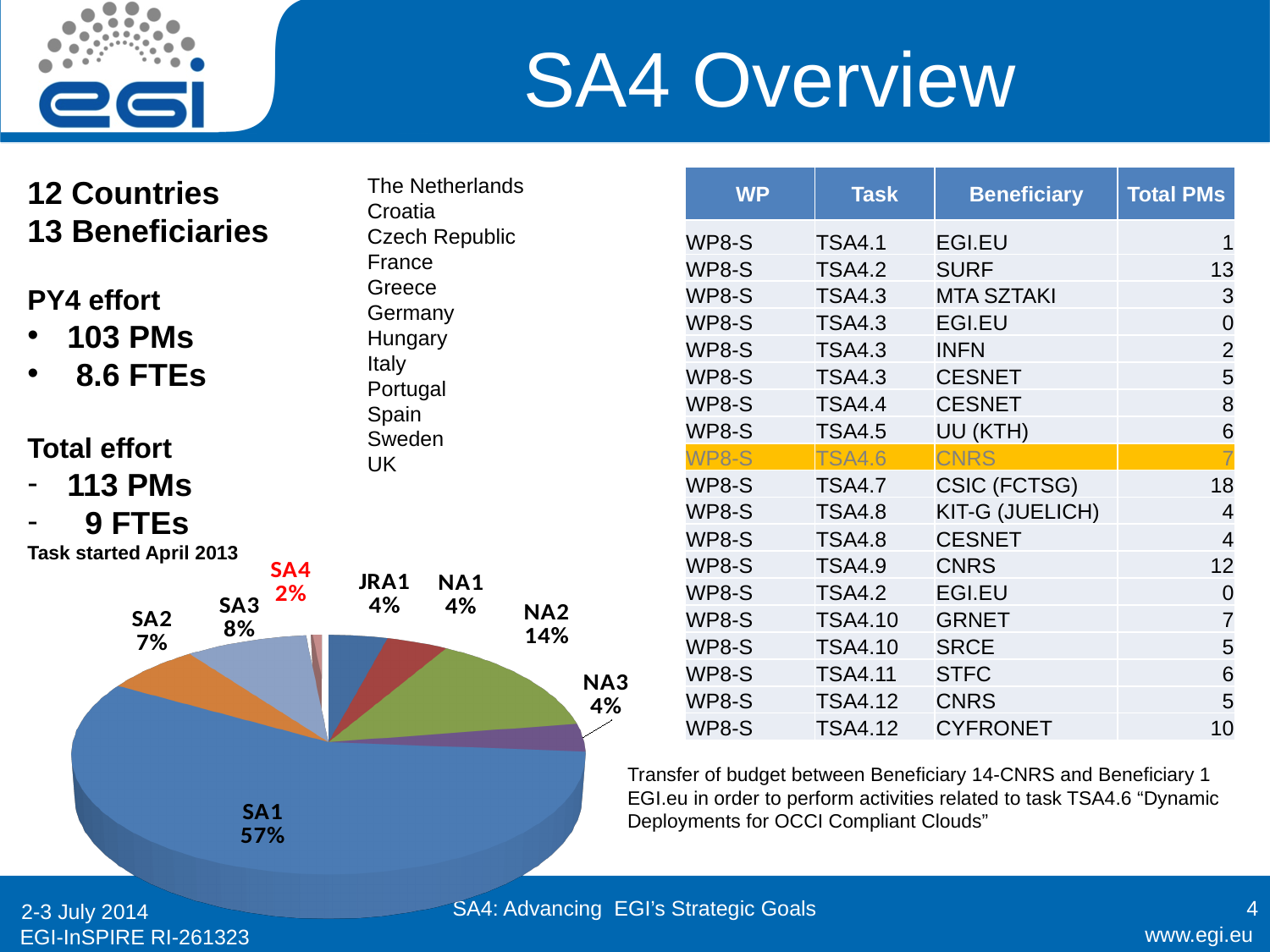
What share of the pie does SA4 have? 2% Which slice label in the pie chart is shown in red text? SA4 Which is larger, SA2 or SA3? SA3 What is the difference in percentage points between SA3 and SA2? 1 What share of the pie does SA1 have? 57% What share of the pie does SA3 have? 8% How many slices does the pie chart have? 8 Which slice of the pie chart is the largest? SA1 What is the difference in percentage points between SA1 and NA2? 43 What share of the pie does NA2 have? 14% What kind of chart is shown on the slide? pie chart Which slice of the pie chart is the smallest? SA4